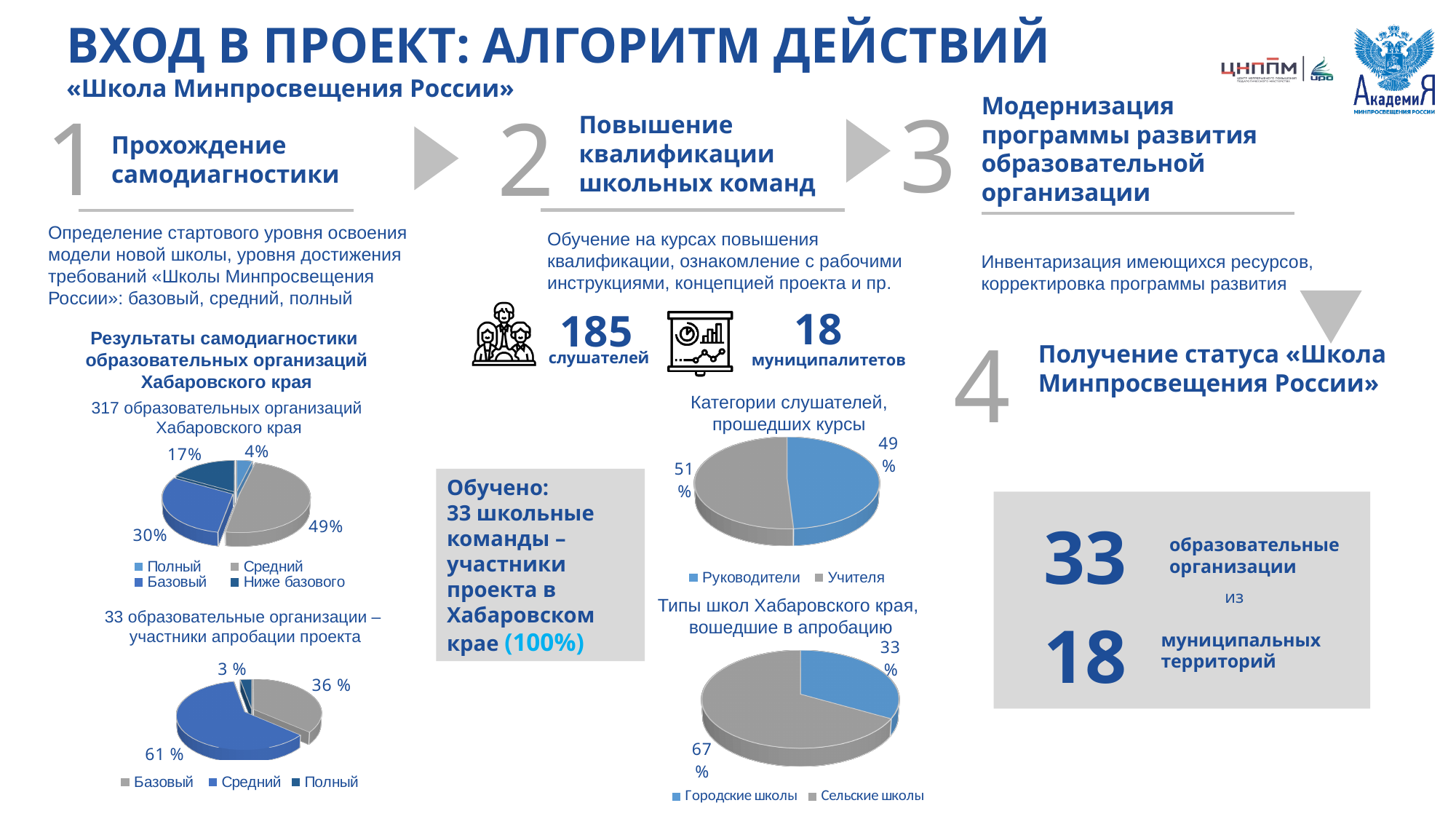
In the pie chart titled "317 образовательных организаций Хабаровского края", which category has the smallest share? Полный How many categories does the legend of the pie chart titled "317 образовательных организаций Хабаровского края" list? 4 In the pie chart titled "33 образовательные организации – участники апробации проекта", what share is labelled for "Полный"? 3 % What type of chart is used for "Типы школ Хабаровского края, вошедшие в апробацию"? Pie chart In the pie chart titled "Типы школ Хабаровского края, вошедшие в апробацию", what share is labelled for "Сельские школы"? 67 % In the pie chart titled "317 образовательных организаций Хабаровского края", what share is labelled for "Ниже базового"? 17% In the pie chart titled "33 образовательные организации – участники апробации проекта", which category has the largest share? Средний In the pie chart titled "317 образовательных организаций Хабаровского края", what share is labelled for "Средний"? 49% In the pie chart titled "Категории слушателей, прошедших курсы", how many categories does the legend list? 2 In the pie chart titled "317 образовательных организаций Хабаровского края", what is the difference between the shares of "Средний" and "Базовый"? 19% In the pie chart titled "Типы школ Хабаровского края, вошедшие в апробацию", which is larger: "Городские школы" or "Сельские школы"? Сельские школы In the pie chart titled "Категории слушателей, прошедших курсы", what share is labelled for "Учителя"? 51%